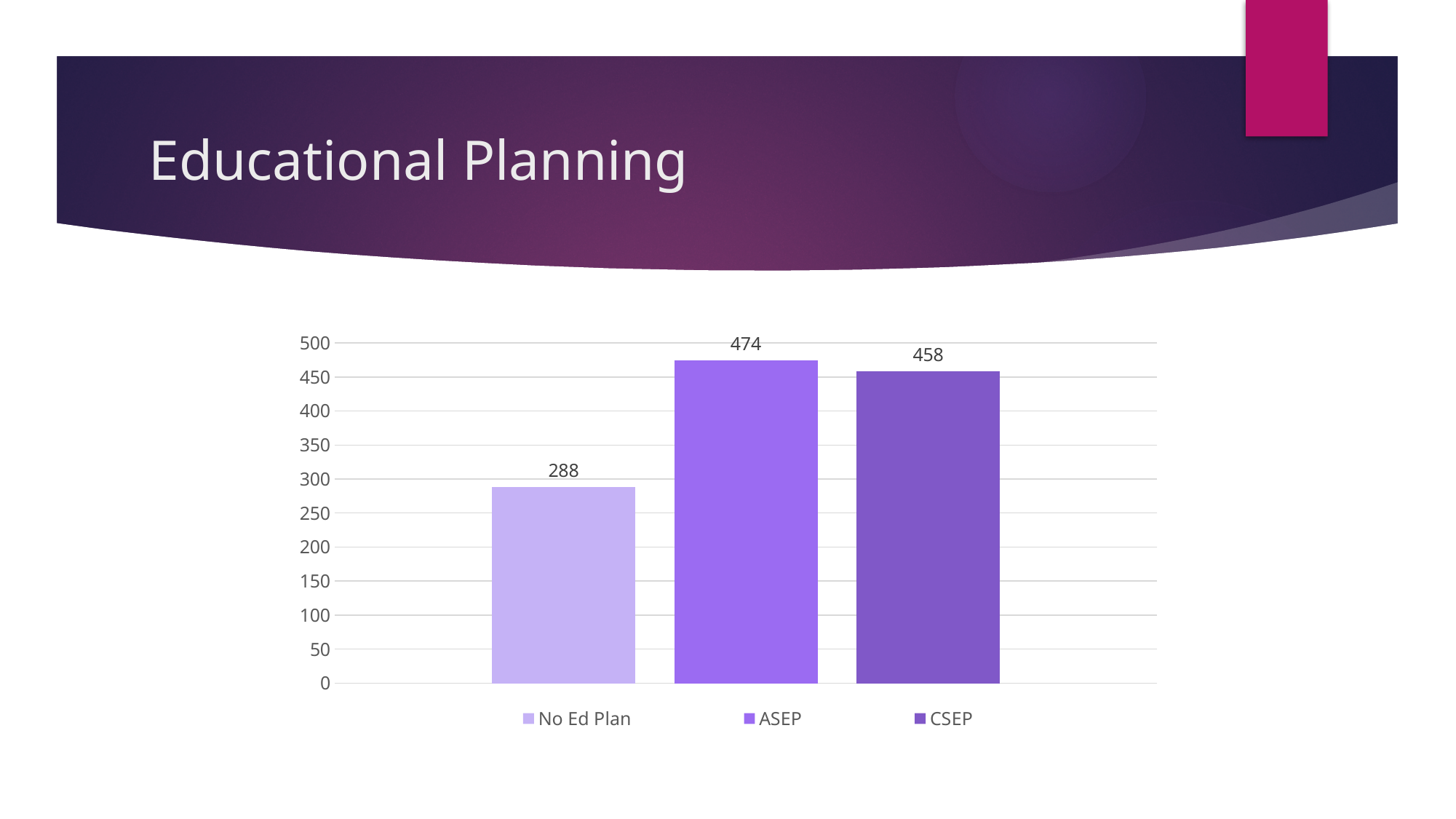
Which category has the highest value? ASEP What is the difference between the values for ASEP and CSEP? 16 What is the value for ASEP? 474 What is the difference between the values for ASEP and No Ed Plan? 186 What is the title of the slide containing the chart? Educational Planning Which is larger, the value for CSEP or the value for No Ed Plan? CSEP What is the value for CSEP? 458 Is the value for No Ed Plan greater or less than 300? less What is the value for No Ed Plan? 288 What kind of chart is shown on the slide? bar chart Which category has the lowest value? No Ed Plan How many categories are shown in the chart? 3